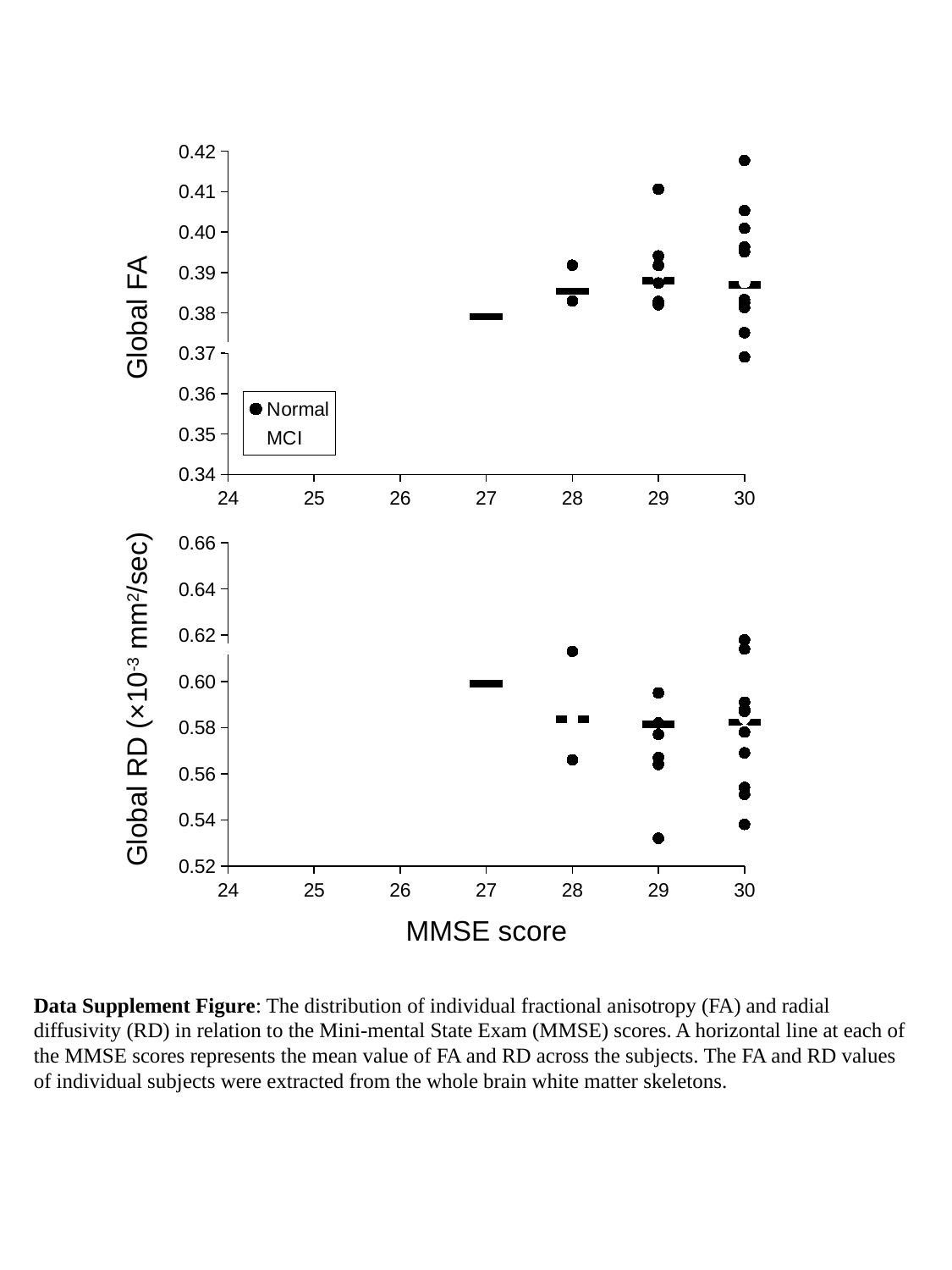
In the bottom chart (Global RD), is the mean line at MMSE score 27 higher or lower than the mean line at MMSE score 29? higher In the top chart (Global FA), is the highest individual point at MMSE score 30 greater or less than 0.41? greater In the top chart (Global FA), is the mean line at MMSE score 28 greater or less than 0.38? greater In the bottom chart (Global RD), is the mean line at MMSE score 28 greater or less than 0.58? greater How many series does the legend in the top chart list? 2 In the bottom chart (Global RD), do the mean lines rise or fall from MMSE score 27 to MMSE score 29? fall What is the x-axis label shared by both charts? MMSE score What are the two series named in the legend of the top chart? Normal and MCI What kind of chart is the top chart (Global FA)? scatter chart In the top chart (Global FA), is the mean line at MMSE score 27 higher or lower than the mean line at MMSE score 29? lower